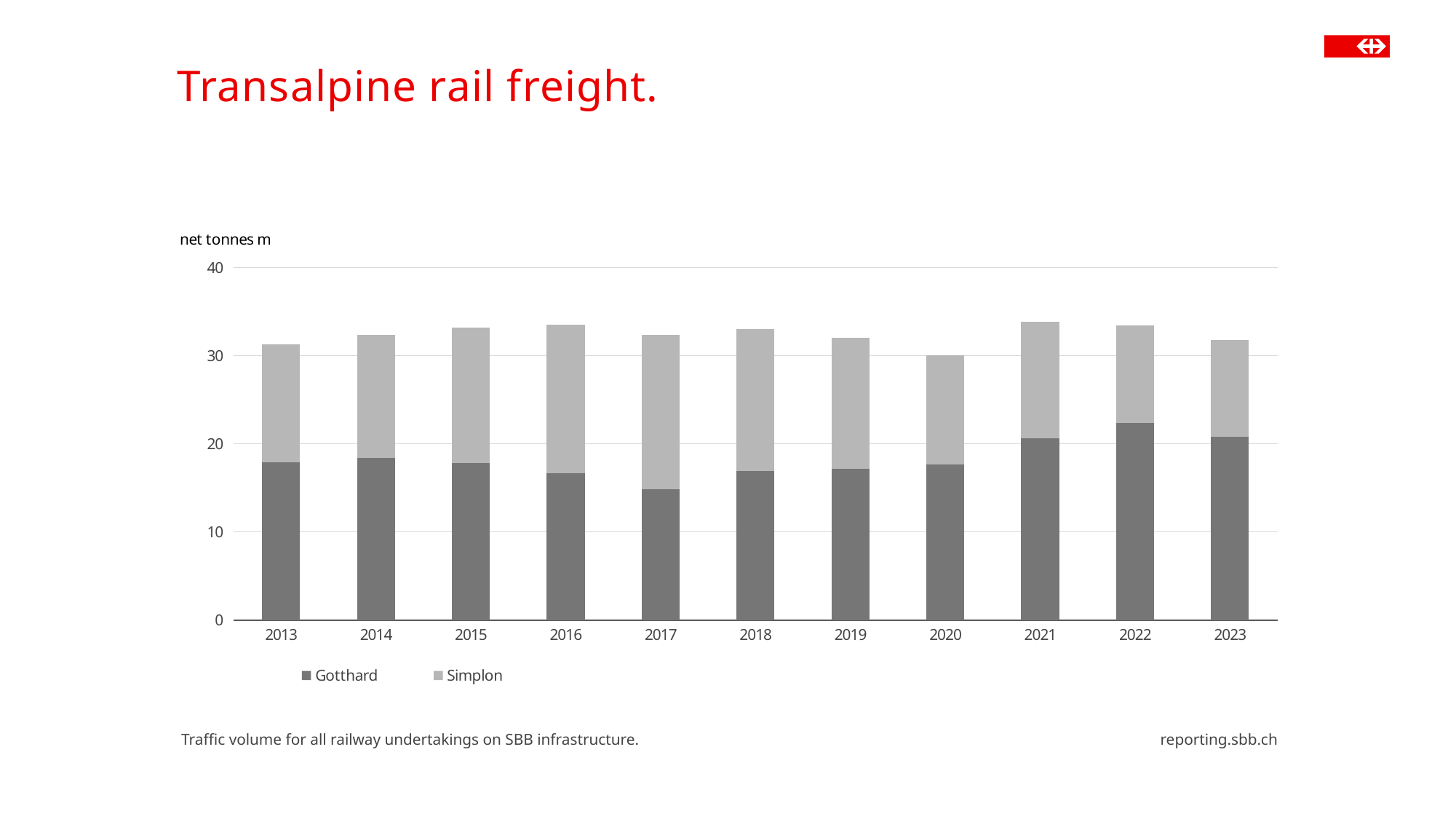
Which is larger, the Gotthard value for 2022 or the Gotthard value for 2017? 2022 What kind of chart is shown on the slide? Stacked bar chart Is the Gotthard value for 2022 greater or less than 20? greater What unit label is shown above the y axis of the chart? net tonnes m In which year is the Gotthard value the highest? 2022 Which two series are listed in the chart's legend? Gotthard and Simplon Which is larger, the Simplon value for 2017 or the Simplon value for 2022? 2017 Is the total stacked bar for 2021 greater or less than 30? greater How many years are shown on the x axis of the chart? 11 Is the Gotthard value for 2017 greater or less than 20? less How many series does the chart's legend list? 2 In which year is the Gotthard value the lowest? 2017